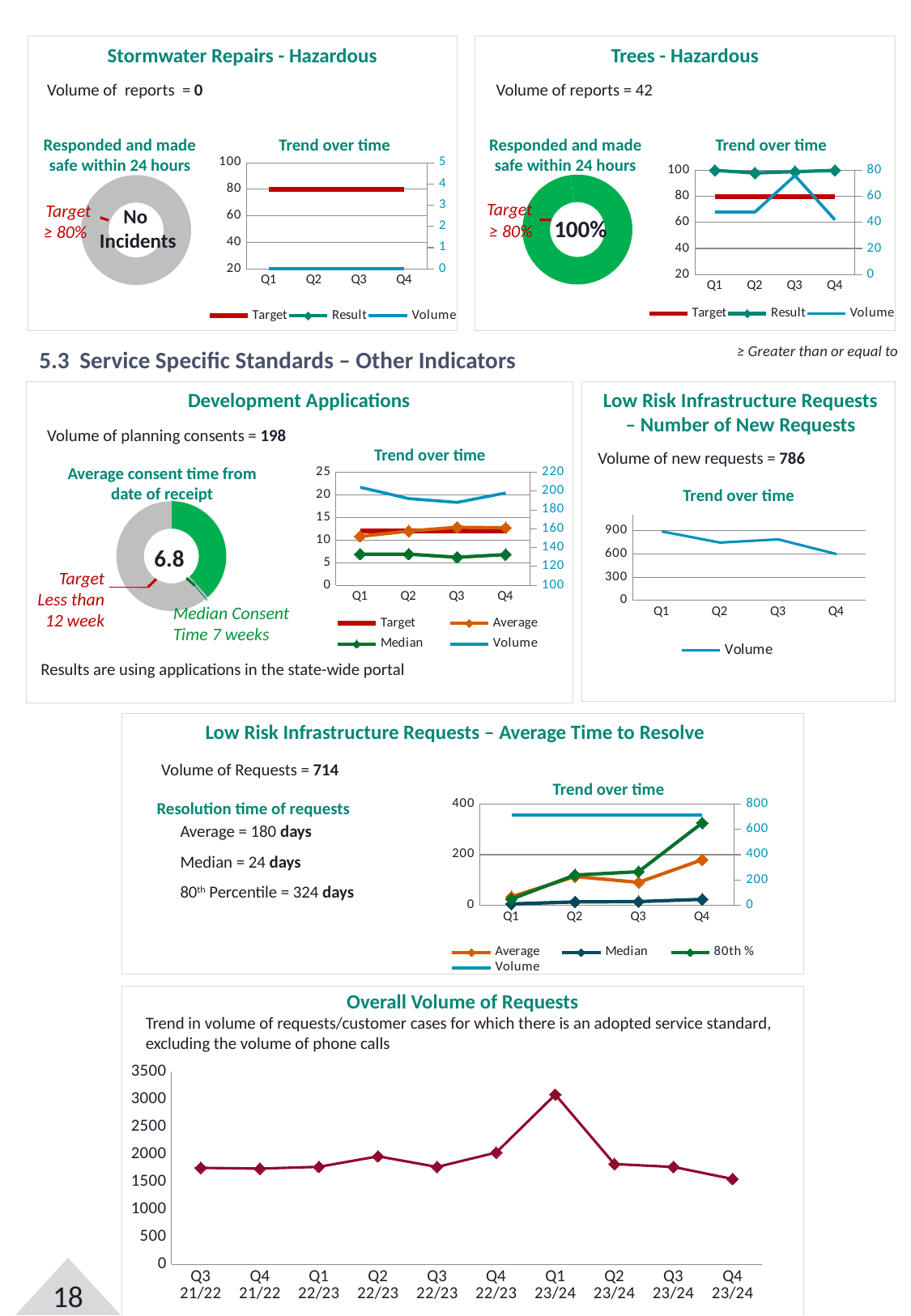
On the Overall Volume of Requests chart, how many quarters are plotted along the x axis? 10 On the Overall Volume of Requests chart, which quarter has the lowest volume? Q4 23/24 On the Trees - Hazardous donut chart, what share is shown for responded and made safe within 24 hours? 100% On the Overall Volume of Requests chart, which quarter has the highest volume? Q1 23/24 On the Overall Volume of Requests chart, what kind of chart is shown? line chart On the Overall Volume of Requests chart, which is larger, the value for Q1 23/24 or Q2 23/24? Q1 23/24 On the Overall Volume of Requests chart, is the value for Q1 23/24 greater or less than 2500? greater On the Low Risk Infrastructure Requests – Average Time to Resolve trend chart, how many series does the legend list? 4 On the Development Applications trend over time chart, how many series does the legend list? 4 On the Overall Volume of Requests chart, is the value for Q4 23/24 greater or less than 2000? less On the Trees - Hazardous trend over time chart, what value does the Target line sit at on the left axis? 80 On the Low Risk Infrastructure Requests – Number of New Requests trend chart, do the values rise or fall from Q1 to Q4? fall